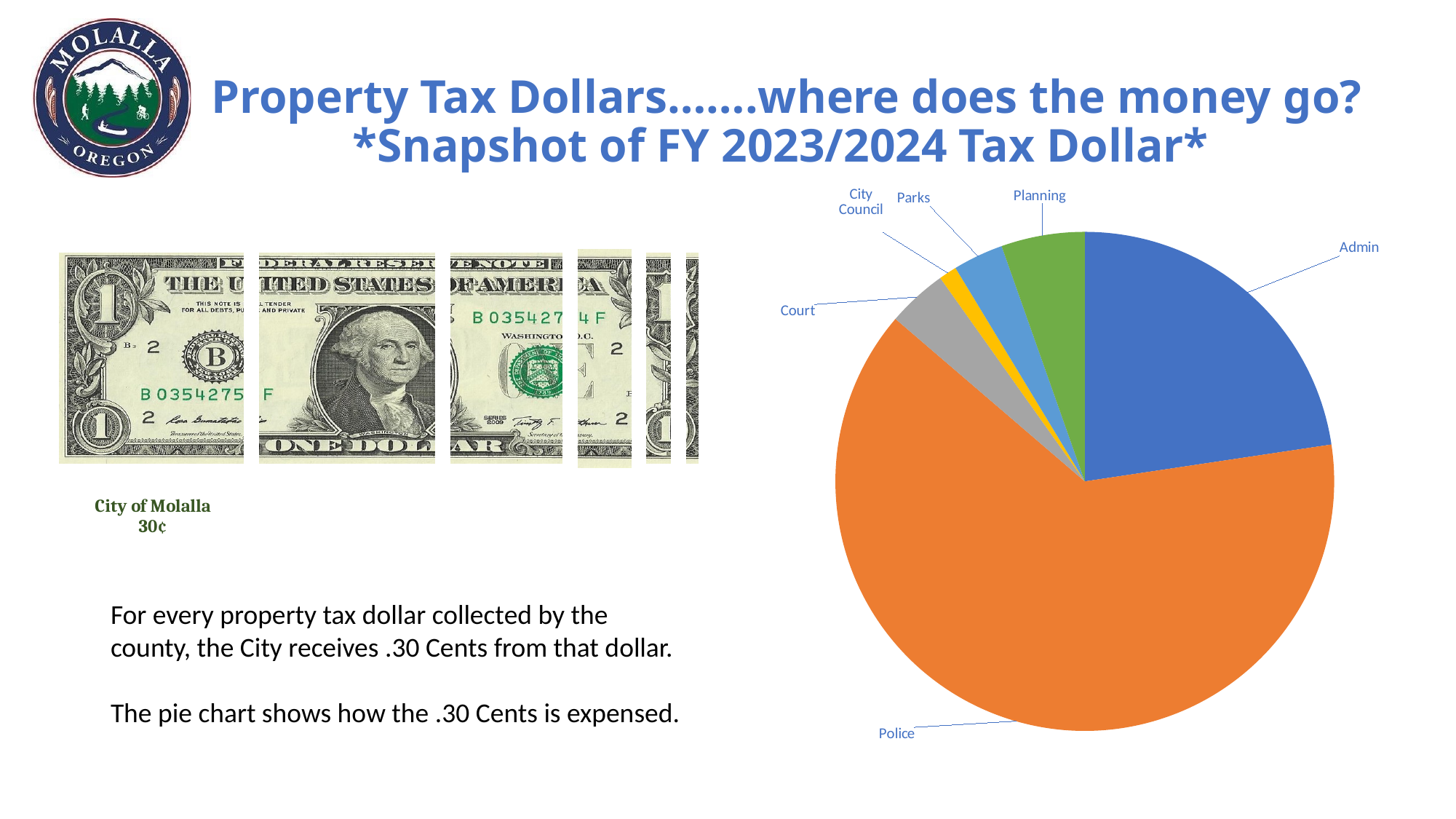
Which slice is larger in the pie chart, Planning or Parks? Planning Which category has the smallest slice of the pie chart? City Council What colour is the Police slice in the pie chart? orange Which category has the largest slice of the pie chart? Police Which slice is larger in the pie chart, Police or Admin? Police What kind of chart is shown on the slide? pie chart How many slices does the pie chart have? 6 Which slice is larger in the pie chart, Admin or Court? Admin What colour is the Admin slice in the pie chart? blue